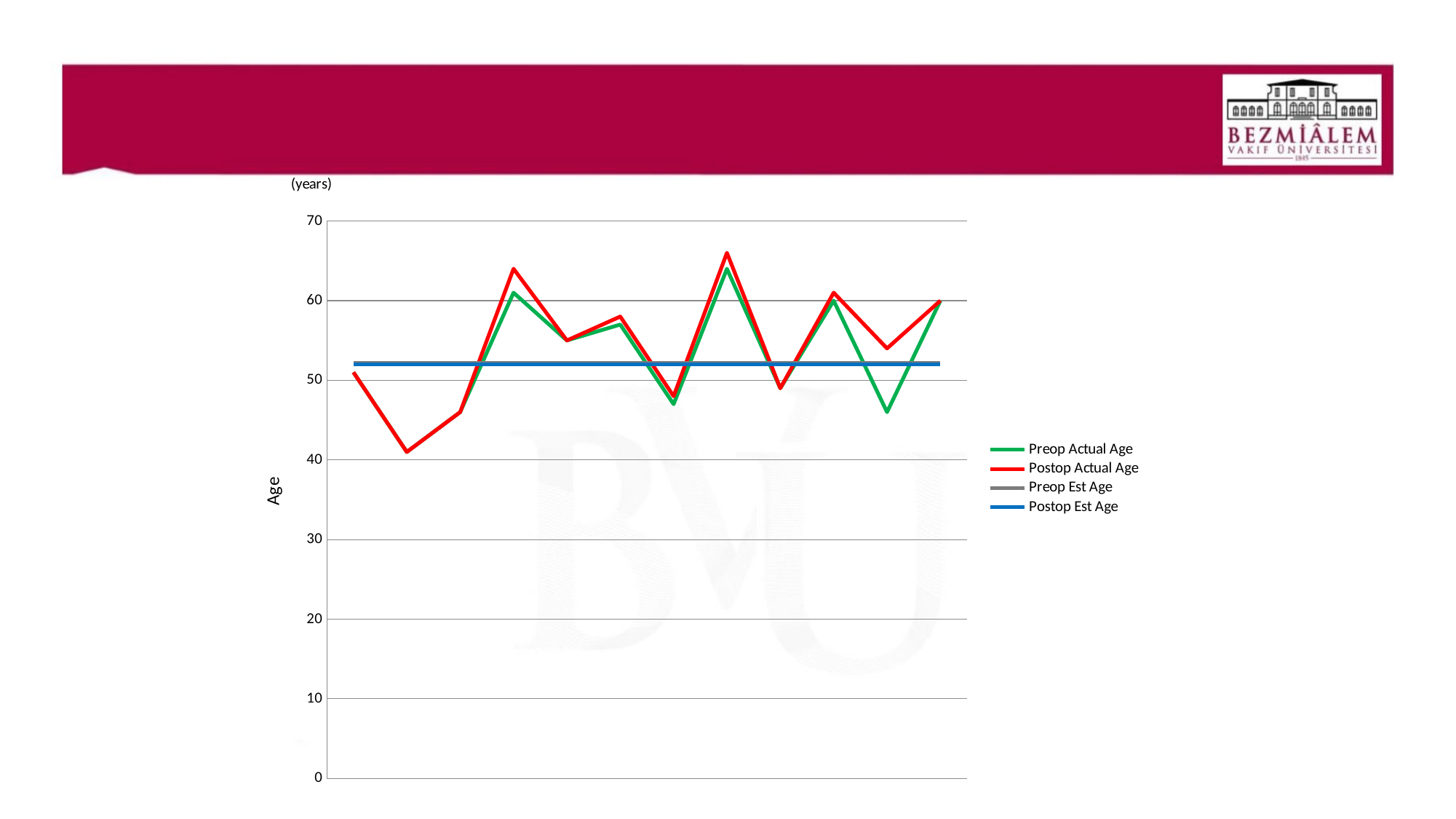
Is the highest point of the Postop Actual Age line greater or less than 60? greater Is the Postop Est Age line greater or less than 50? greater Does the Postop Est Age line rise, fall, or stay flat along the x axis? stays flat Is the lowest point of the Postop Actual Age line greater or less than 50? less What is the highest tick value shown on the vertical axis? 70 What unit is given for the vertical axis, shown above the chart? years How many series does the legend list? 4 What is the label of the vertical axis? Age What kind of chart is shown on the slide? line chart How many data points does the Postop Actual Age line have? 12